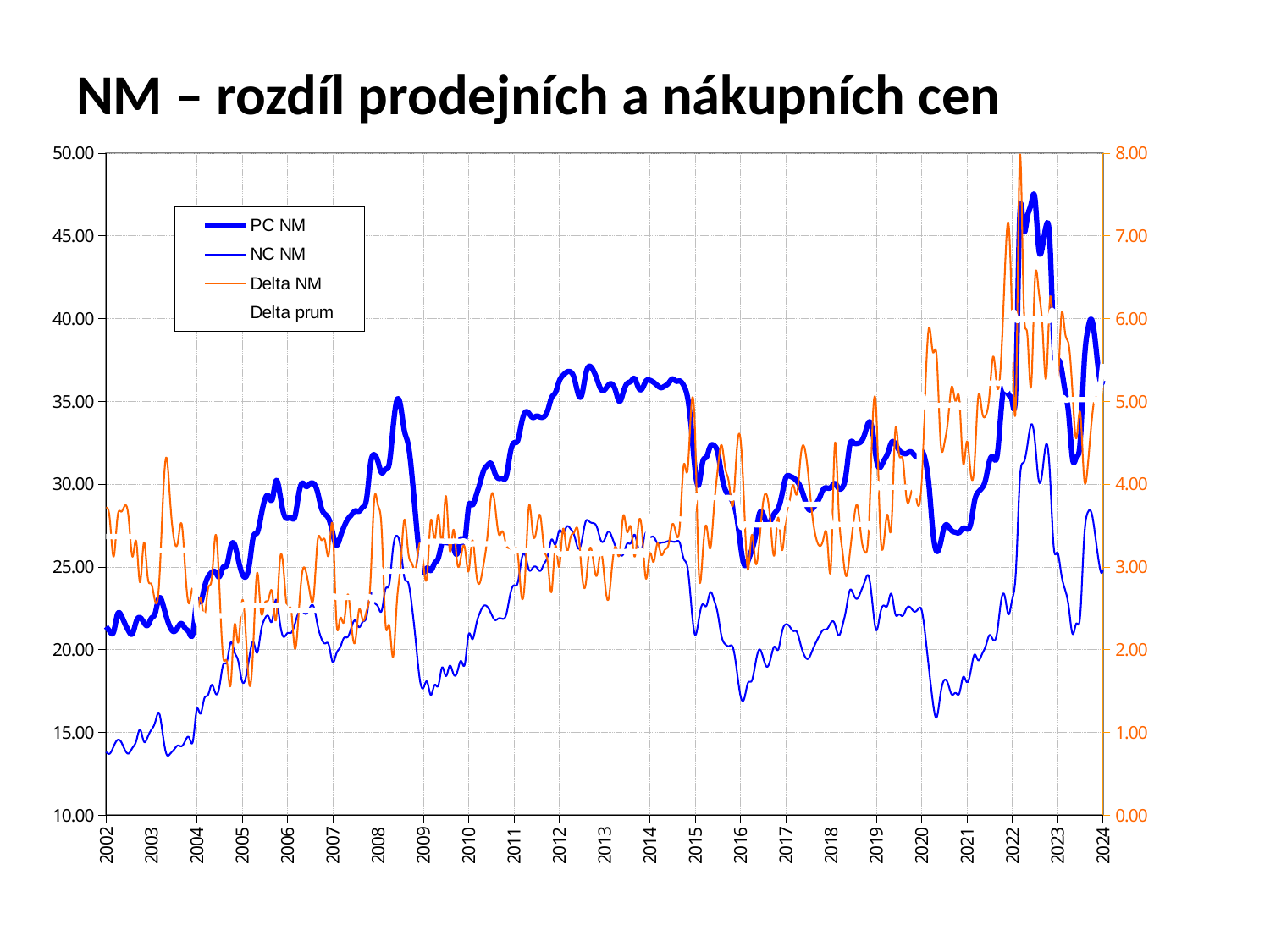
Is the lowest value of NC NM in 2016 greater or less than 20.00? less What kind of chart is shown on the slide? line chart Is the peak value of PC NM in 2022 greater or less than 45.00? greater Is the value of PC NM at the start of 2002 greater or less than 25.00? less Which series is higher throughout the chart, PC NM or NC NM? PC NM Does the NC NM line rise or fall from 2002 to 2004? rise How many series does the legend list? 4 What is the title of the chart? NM – rozdíl prodejních a nákupních cen What colour is the Delta NM line? orange